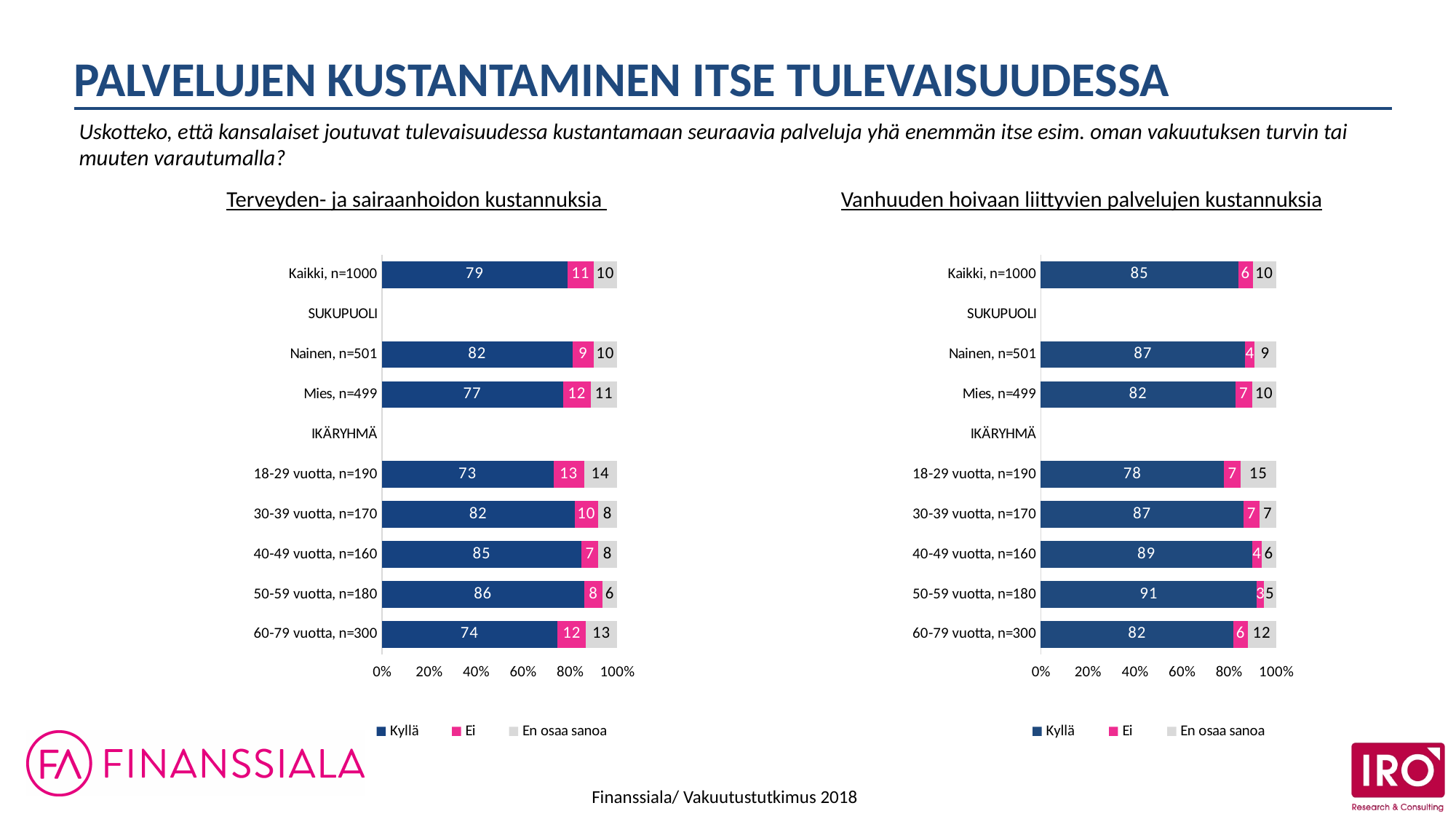
What kind of chart is the 'Terveyden- ja sairaanhoidon kustannuksia' chart? Stacked bar chart In the 'Vanhuuden hoivaan liittyvien palvelujen kustannuksia' chart, which category has the highest En osaa sanoa value? 18-29 vuotta, n=190 In the 'Vanhuuden hoivaan liittyvien palvelujen kustannuksia' chart, what is the Kyllä value for 50-59 vuotta, n=180? 91 In the 'Vanhuuden hoivaan liittyvien palvelujen kustannuksia' chart, what is the total of the stacked bar for Mies, n=499? 99 In the 'Vanhuuden hoivaan liittyvien palvelujen kustannuksia' chart, is the Kyllä value for 60-79 vuotta, n=300 larger or smaller than the Kyllä value for 40-49 vuotta, n=160? smaller In the 'Terveyden- ja sairaanhoidon kustannuksia' chart, what is the Kyllä value for Kaikki, n=1000? 79 In the 'Terveyden- ja sairaanhoidon kustannuksia' chart, which category has the lowest Kyllä value? 18-29 vuotta, n=190 In the 'Terveyden- ja sairaanhoidon kustannuksia' chart, what is the difference between the Kyllä values for Nainen, n=501 and Mies, n=499? 5 How many series does the legend of the 'Vanhuuden hoivaan liittyvien palvelujen kustannuksia' chart list? 3 In the 'Terveyden- ja sairaanhoidon kustannuksia' chart, which category has the highest Kyllä value? 50-59 vuotta, n=180 In the 'Terveyden- ja sairaanhoidon kustannuksia' chart, which legend entry is shown in pink? Ei In the 'Terveyden- ja sairaanhoidon kustannuksia' chart, what is the Ei value for 18-29 vuotta, n=190? 13